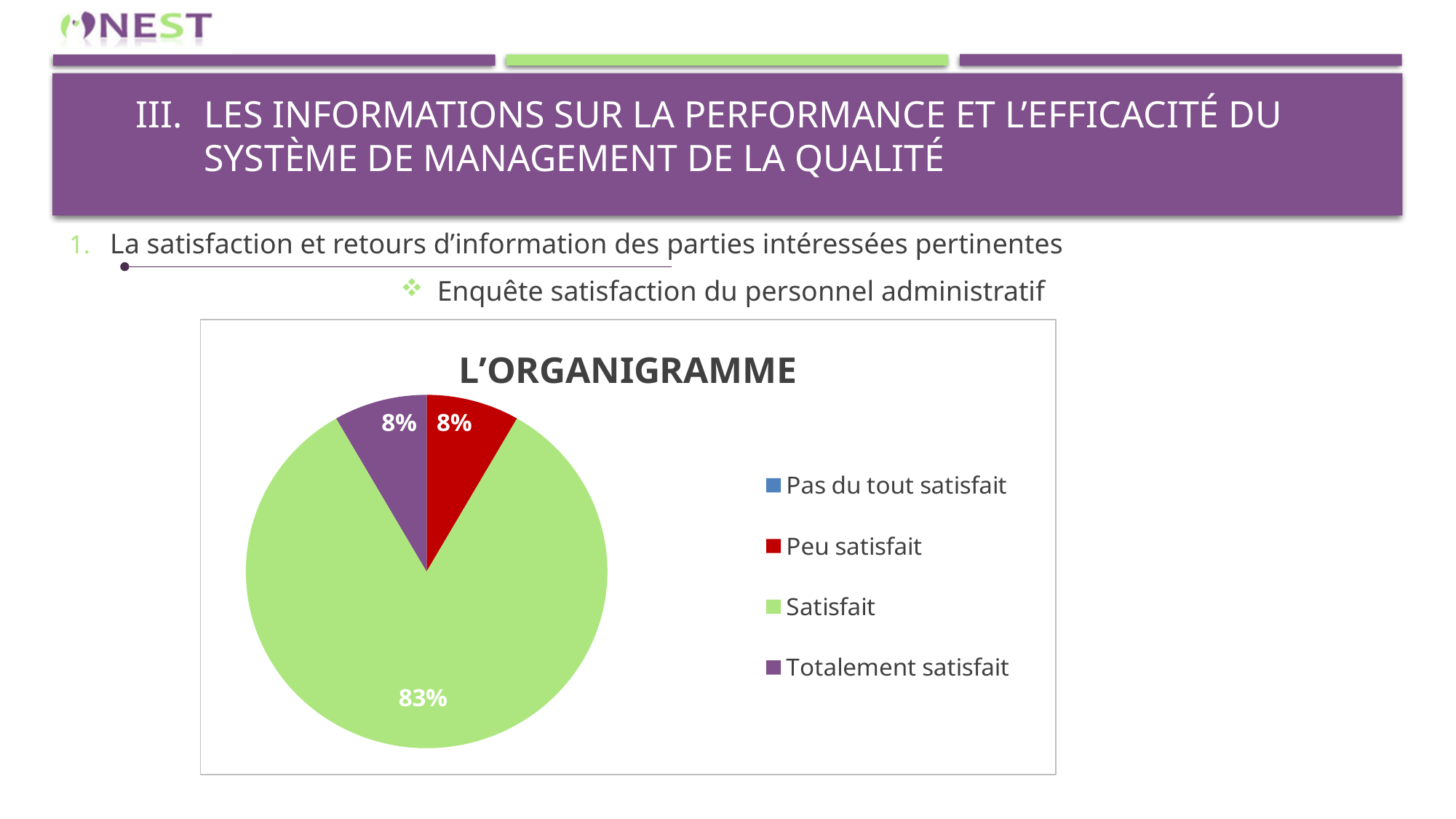
Which legend category has no visible slice in the pie? Pas du tout satisfait Is the share for 'Satisfait' greater or less than 50%? greater What percentage of respondents are 'Totalement satisfait'? 8% What is the difference between the 'Satisfait' share and the 'Peu satisfait' share? 75% What type of chart is shown on the slide? Pie chart Which category has the largest share of the pie? Satisfait Which is larger, the share for 'Satisfait' or the share for 'Totalement satisfait'? Satisfait What is the title of the chart? L'ORGANIGRAMME What colour is the 'Satisfait' slice? Green How many categories does the legend list? 4 What percentage of respondents are 'Peu satisfait'? 8% What percentage of respondents are 'Satisfait'? 83%